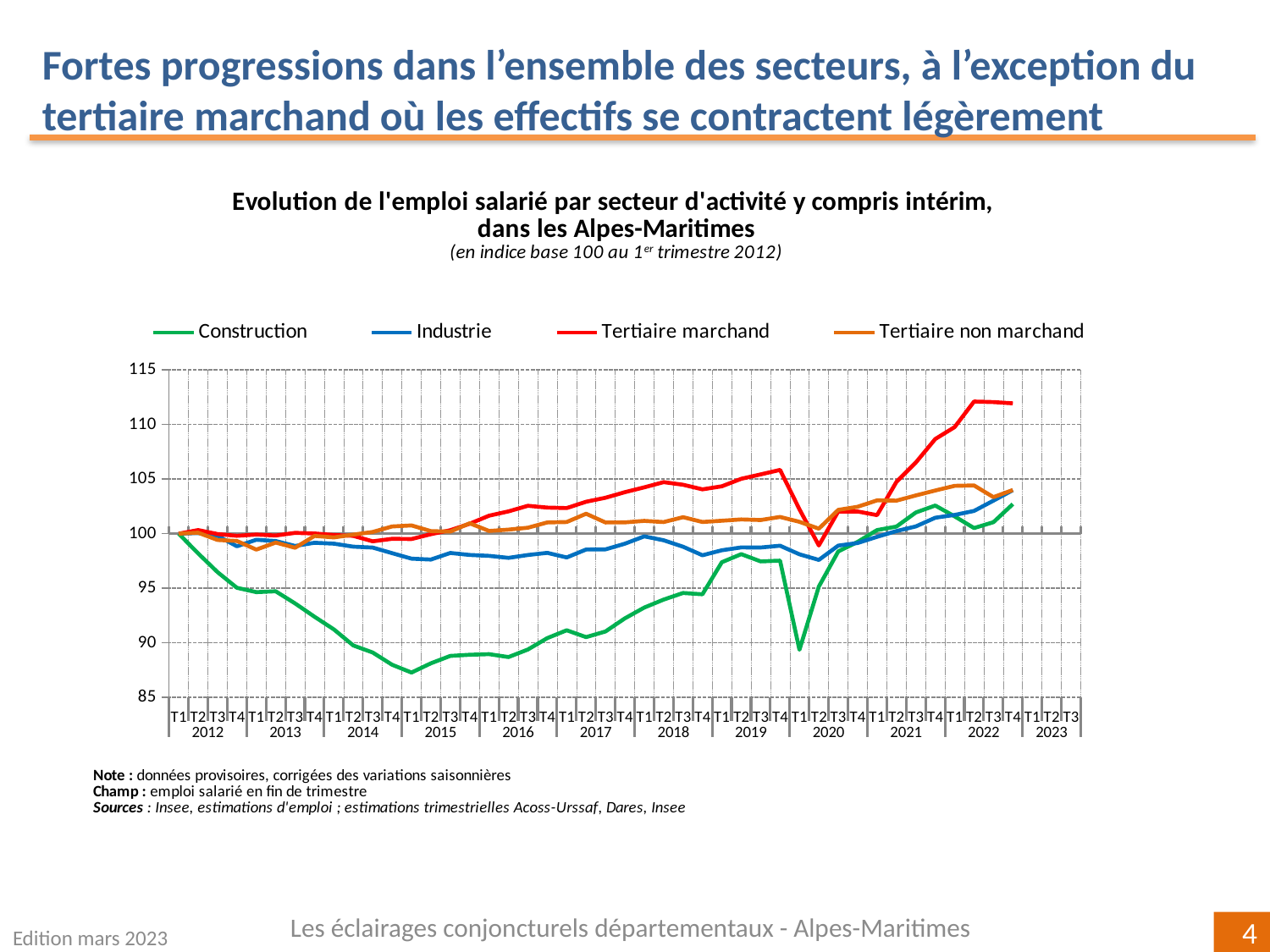
Is the value for Tertiaire marchand at T2 2022 greater or less than 110? greater Which series has the highest value at T4 2022? Tertiaire marchand What is the base value of the index, as stated in the chart subtitle? 100 Which series is shown in green in the legend? Construction Is the value for Construction at T1 2020 greater or less than 95? less How many series does the legend list? 4 What kind of chart is shown on the slide? line chart Is the value for Construction at T1 2015 greater or less than 90? less Does the Tertiaire marchand series rise or fall between T1 2021 and T2 2022? rise Which series has the lowest value at T1 2015? Construction At T1 2020, which is larger: the value for Tertiaire marchand or the value for Construction? Tertiaire marchand